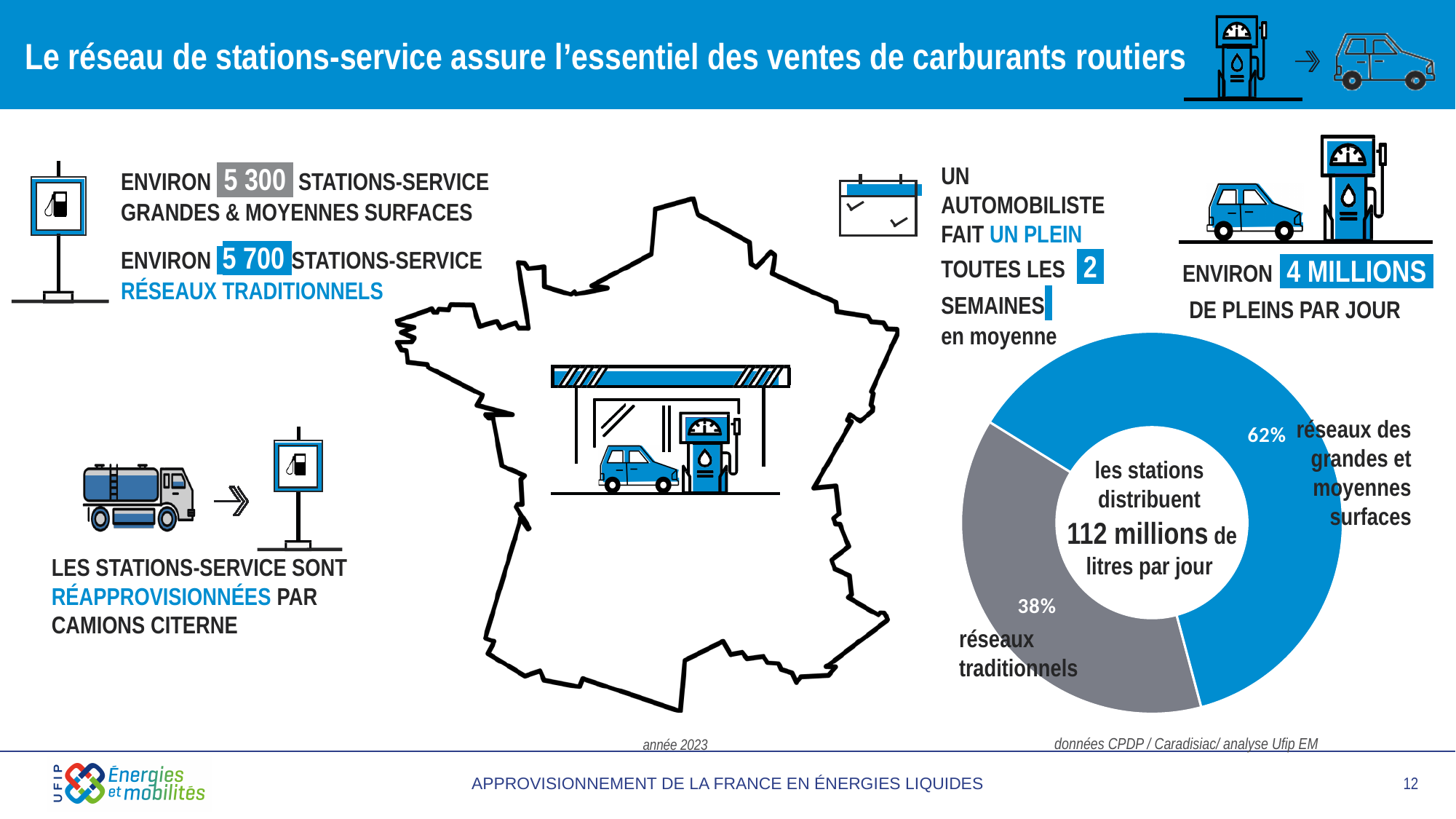
What kind of chart is shown on the right of the slide? Pie chart (donut) Which slice of the pie chart is the smallest? réseaux traditionnels What is the difference in percentage points between the 'réseaux des grandes et moyennes surfaces' slice and the 'réseaux traditionnels' slice? 24 percentage points Which slice of the pie chart is the largest? réseaux des grandes et moyennes surfaces What share of the pie chart is labelled 'réseaux des grandes et moyennes surfaces'? 62% How many slices does the pie chart have? 2 Is the share for 'réseaux traditionnels' greater or less than 50%? less What text is written in the centre of the donut chart? les stations distribuent 112 millions de litres par jour What colour is the 'réseaux traditionnels' slice of the pie chart? Grey What share of the pie chart is labelled 'réseaux traditionnels'? 38% Which is larger in the pie chart: 'réseaux traditionnels' or 'réseaux des grandes et moyennes surfaces'? réseaux des grandes et moyennes surfaces